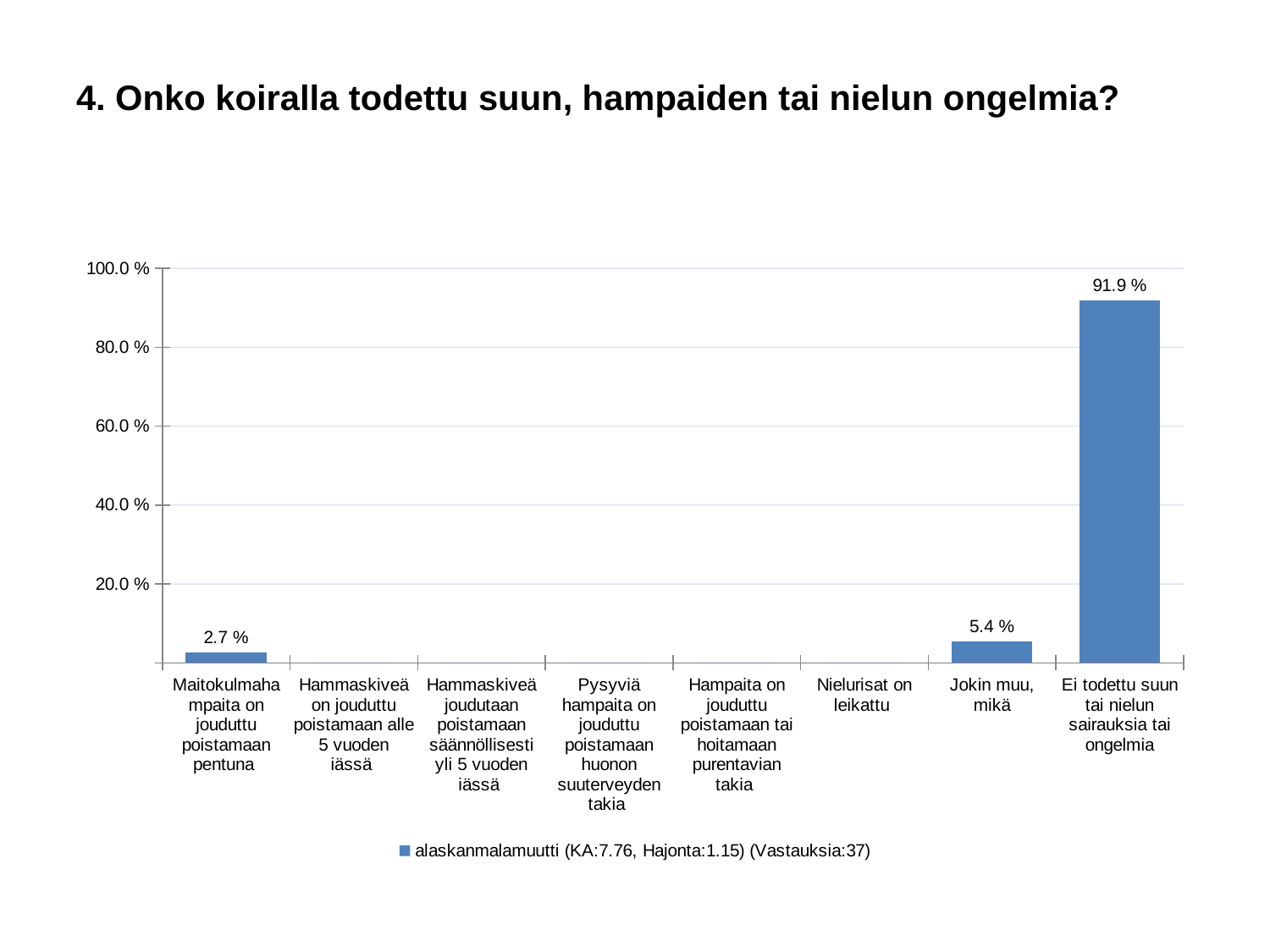
What is the title of the slide? 4. Onko koiralla todettu suun, hampaiden tai nielun ongelmia? What is the difference between the values for "Jokin muu, mikä" and "Maitokulmahampaita on jouduttu poistamaan pentuna"? 2.7 % How many categories are shown on the x axis? 8 Is the value for "Ei todettu suun tai nielun sairauksia tai ongelmia" greater or less than 80.0 %? greater Which is larger, the value for "Jokin muu, mikä" or the value for "Maitokulmahampaita on jouduttu poistamaan pentuna"? Jokin muu, mikä What is the value for "Ei todettu suun tai nielun sairauksia tai ongelmia"? 91.9 % How many series does the legend list? 1 What is the value for "Jokin muu, mikä"? 5.4 % What kind of chart is shown on the slide? bar chart Which category has the highest value? Ei todettu suun tai nielun sairauksia tai ongelmia What is the difference between the values for "Ei todettu suun tai nielun sairauksia tai ongelmia" and "Jokin muu, mikä"? 86.5 % What is the value for "Maitokulmahampaita on jouduttu poistamaan pentuna"? 2.7 %